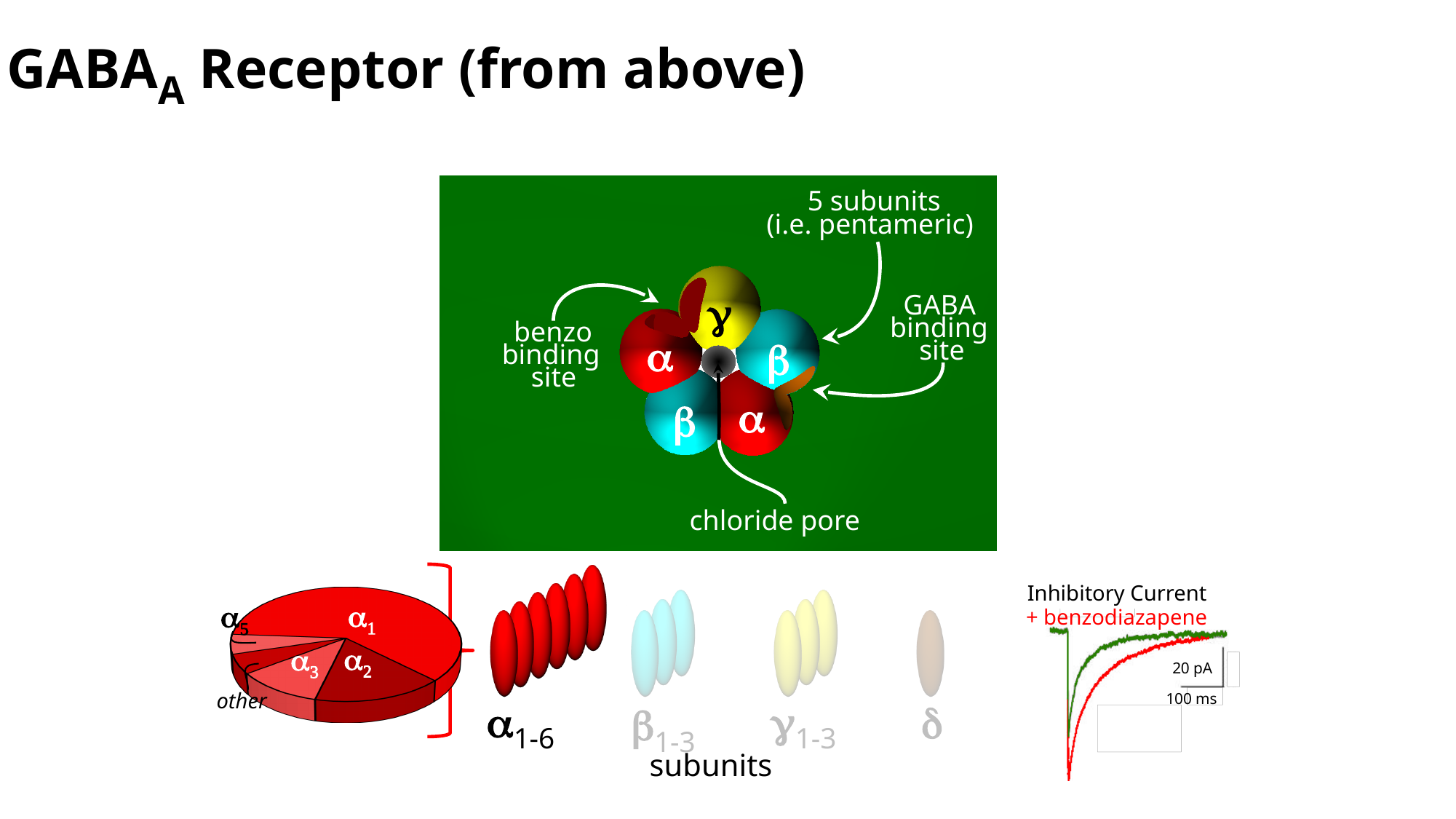
Which slice of the pie chart at the bottom left of the slide is the largest? α1 In the pie chart at the bottom left of the slide, which slice is larger, α1 or α2? α1 How many traces are plotted in the 'Inhibitory Current' chart at the bottom right of the slide? 2 In the 'Inhibitory Current' chart at the bottom right of the slide, what colour is the '+ benzodiazapene' trace? red How many slices does the pie chart at the bottom left of the slide have? 5 In the 'Inhibitory Current' chart at the bottom right of the slide, do the traces move toward or away from the baseline as time increases after the initial peak? toward the baseline What kind of chart is the 'Inhibitory Current' chart at the bottom right of the slide? line chart What kind of chart is the chart at the bottom left of the slide showing the alpha subunit subtypes? pie chart In the 'Inhibitory Current' chart at the bottom right of the slide, which trace returns to baseline more slowly, the green trace or the red '+ benzodiazapene' trace? red (+ benzodiazapene) In the pie chart at the bottom left of the slide, which slice is larger, α2 or α3? α2 Which slice of the pie chart at the bottom left of the slide is labelled in italics? other